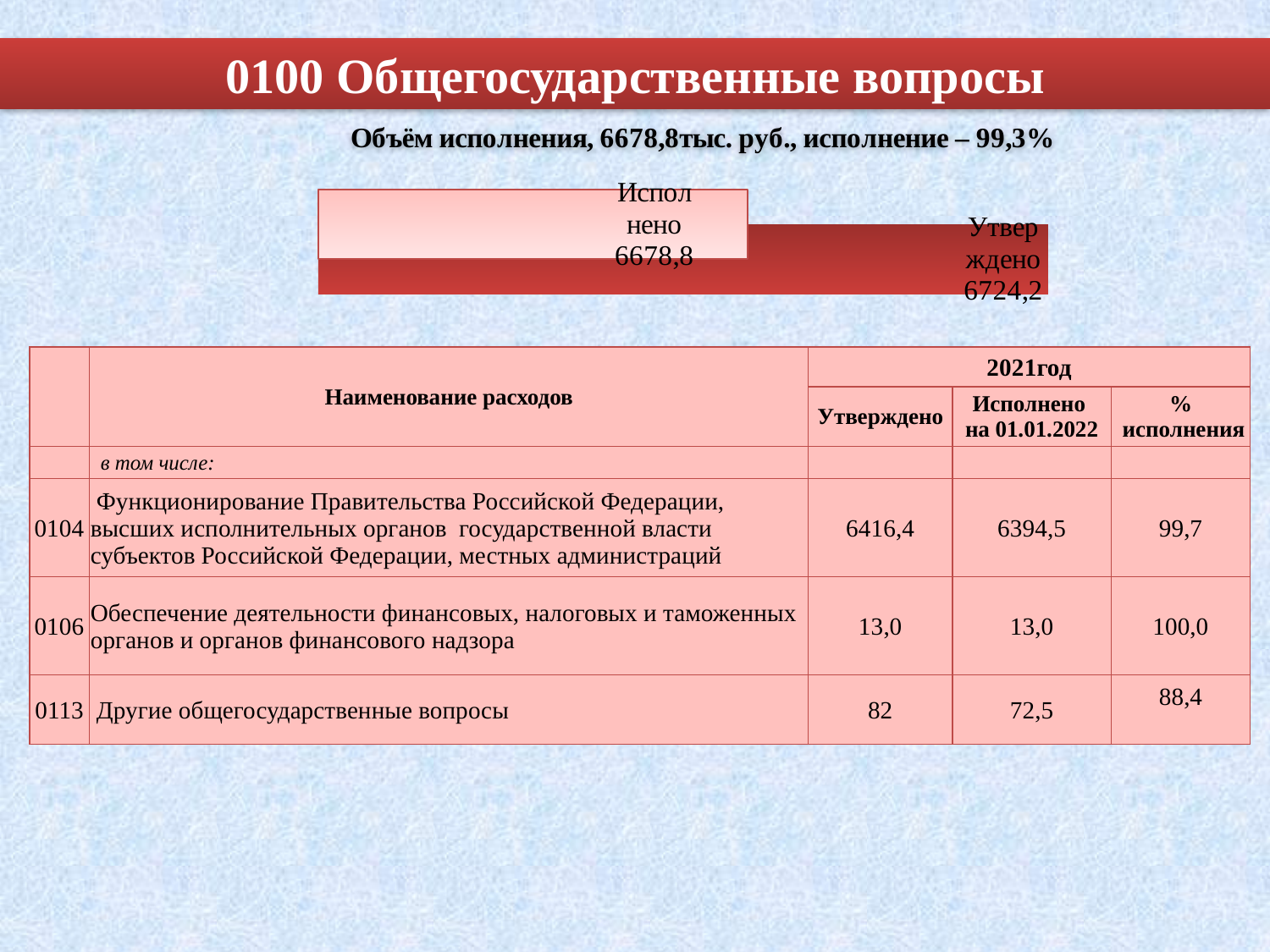
What is the difference between the "Утверждено" value and the "Исполнено" value in the chart? 45,4 What value is shown for the bar labelled "Исполнено" in the chart? 6678,8 Which bar in the chart has the higher value, "Исполнено" or "Утверждено"? Утверждено Which bar in the chart is drawn in light pink? Исполнено Which bar in the chart has the lower value? Исполнено How many bars are plotted in the chart? 2 Is the value for "Исполнено" larger or smaller than the value for "Утверждено" in the chart? smaller What kind of chart is shown on the slide? bar chart Which bar in the chart is drawn in dark red? Утверждено What value is shown for the bar labelled "Утверждено" in the chart? 6724,2